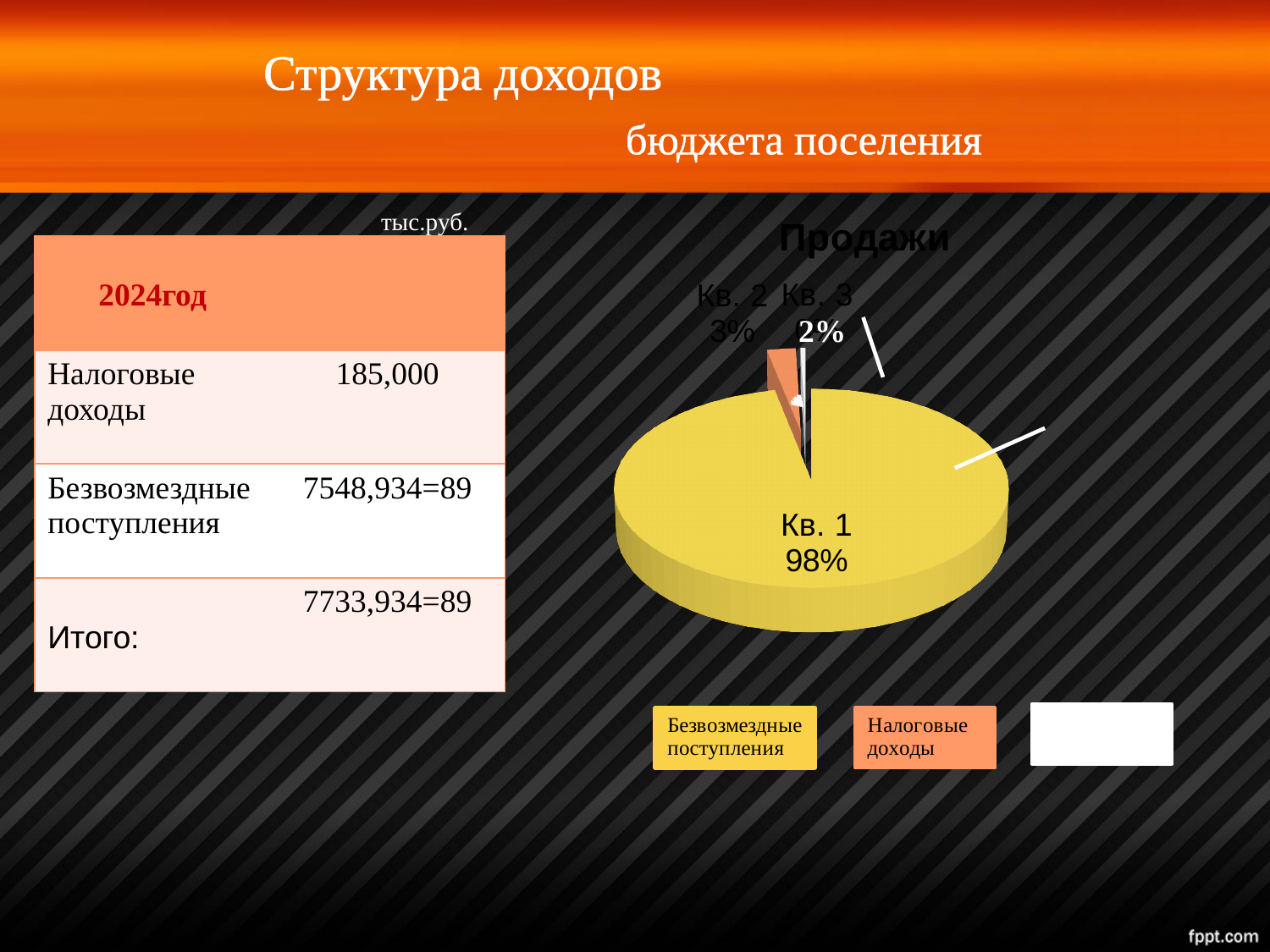
What is the difference in percentage points between the Кв. 1 slice and the Кв. 3 slice? 96 Which slice is larger, Кв. 2 or Кв. 3? Кв. 2 Which slice of the pie chart is the largest? Кв. 1 What is the title of the pie chart? Продажи What percentage does the Кв. 3 slice of the pie chart represent? 2% What percentage does the Кв. 1 slice of the pie chart represent? 98% What colour is the largest slice of the pie chart? yellow Which slice of the pie chart is the smallest? Кв. 3 What kind of chart is shown on the slide? pie chart How many slices does the pie chart have? 3 What percentage does the Кв. 2 slice of the pie chart represent? 3% Is the share of the Кв. 1 slice greater or less than 50%? greater